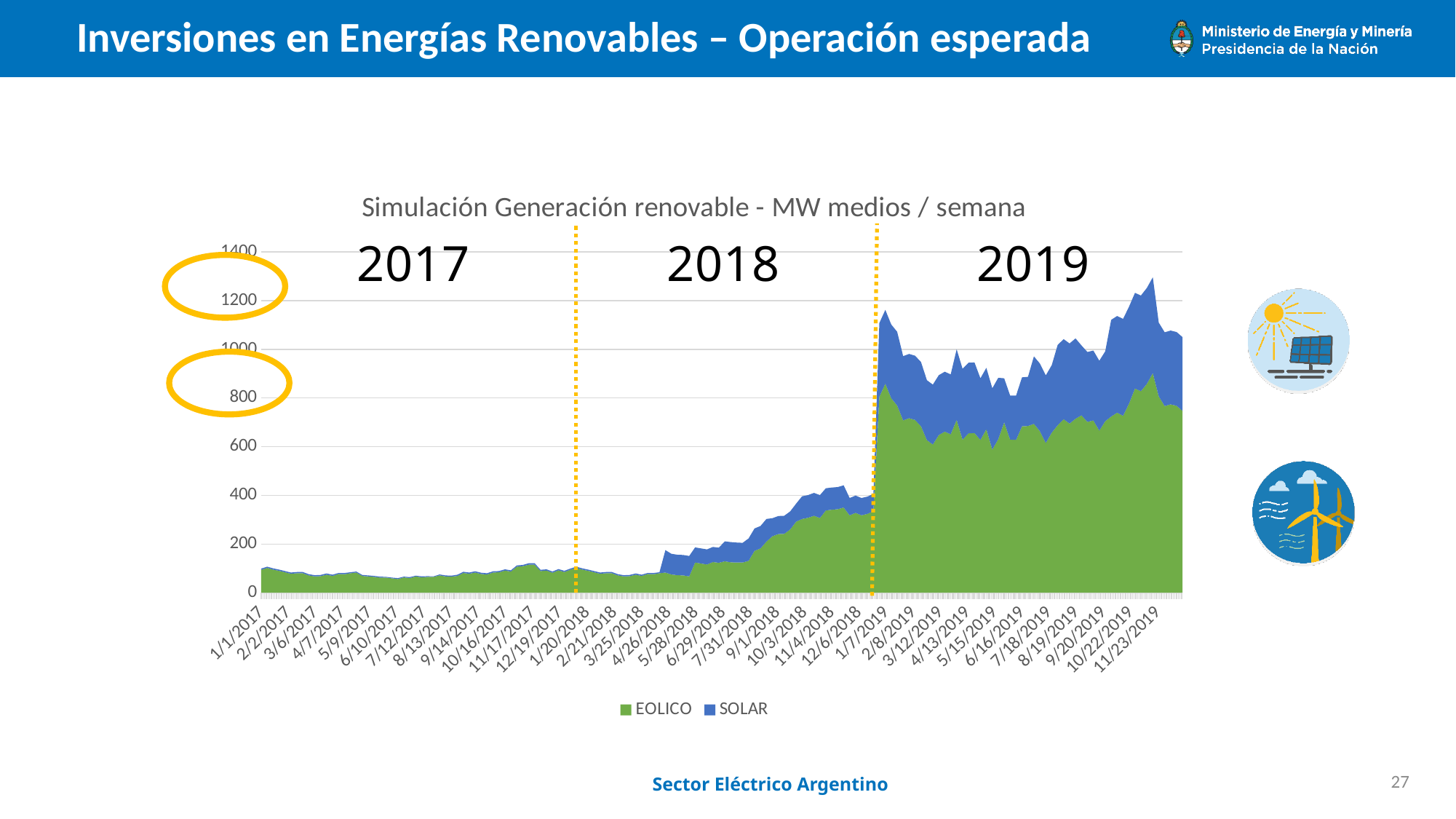
Is the EOLICO value at 11/23/2019 greater or less than 600? greater Is the total value at 12/6/2018 greater or less than 600? less What is the highest value shown on the vertical axis? 1400 Is the total value at 11/23/2019 greater or less than 800? greater How many series does the chart legend list? 2 What kind of chart is shown on the slide? Stacked area chart In 2019, which series contributes more to the total, EOLICO or SOLAR? EOLICO Do the plotted values generally rise or fall from 2017 to 2019? Rise What are the two series named in the chart legend? EOLICO and SOLAR What is the title of the chart? Simulación Generación renovable - MW medios / semana